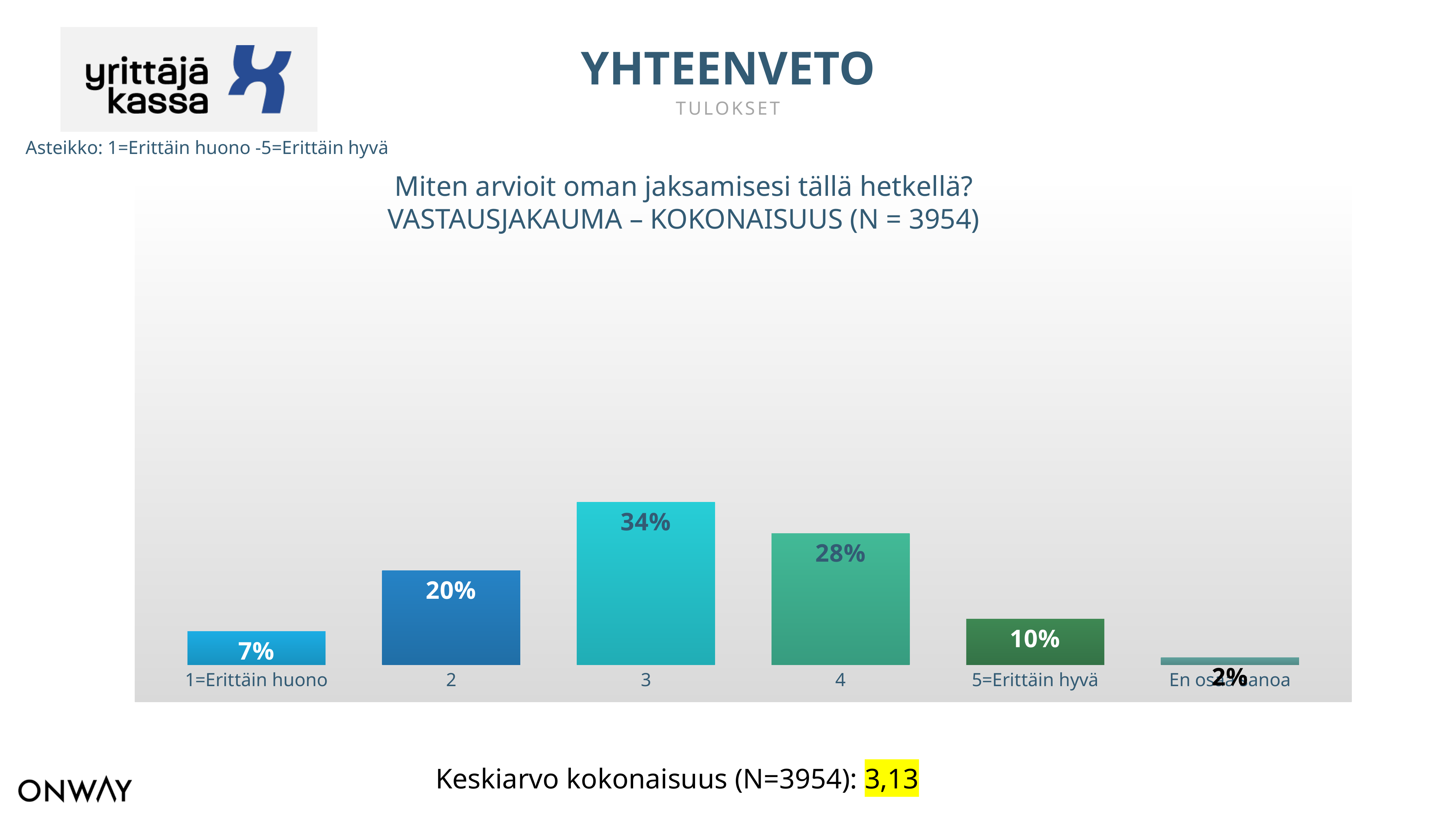
How many categories are shown in the chart? 6 What percentage of respondents chose 2? 20% Which category has the highest share of responses? 3 What is the N value given in the chart title? 3954 What percentage of respondents chose 5=Erittäin hyvä? 10% What percentage of respondents chose 3? 34% What percentage of respondents chose 1=Erittäin huono? 7% What kind of chart is shown on the slide? bar chart What is the difference in percentage points between category 2 and 5=Erittäin hyvä? 10 What is the difference in percentage points between category 3 and category 4? 6 Which is larger, the share for category 4 or the share for category 2? 4 Which category has the lowest share of responses? En osaa sanoa